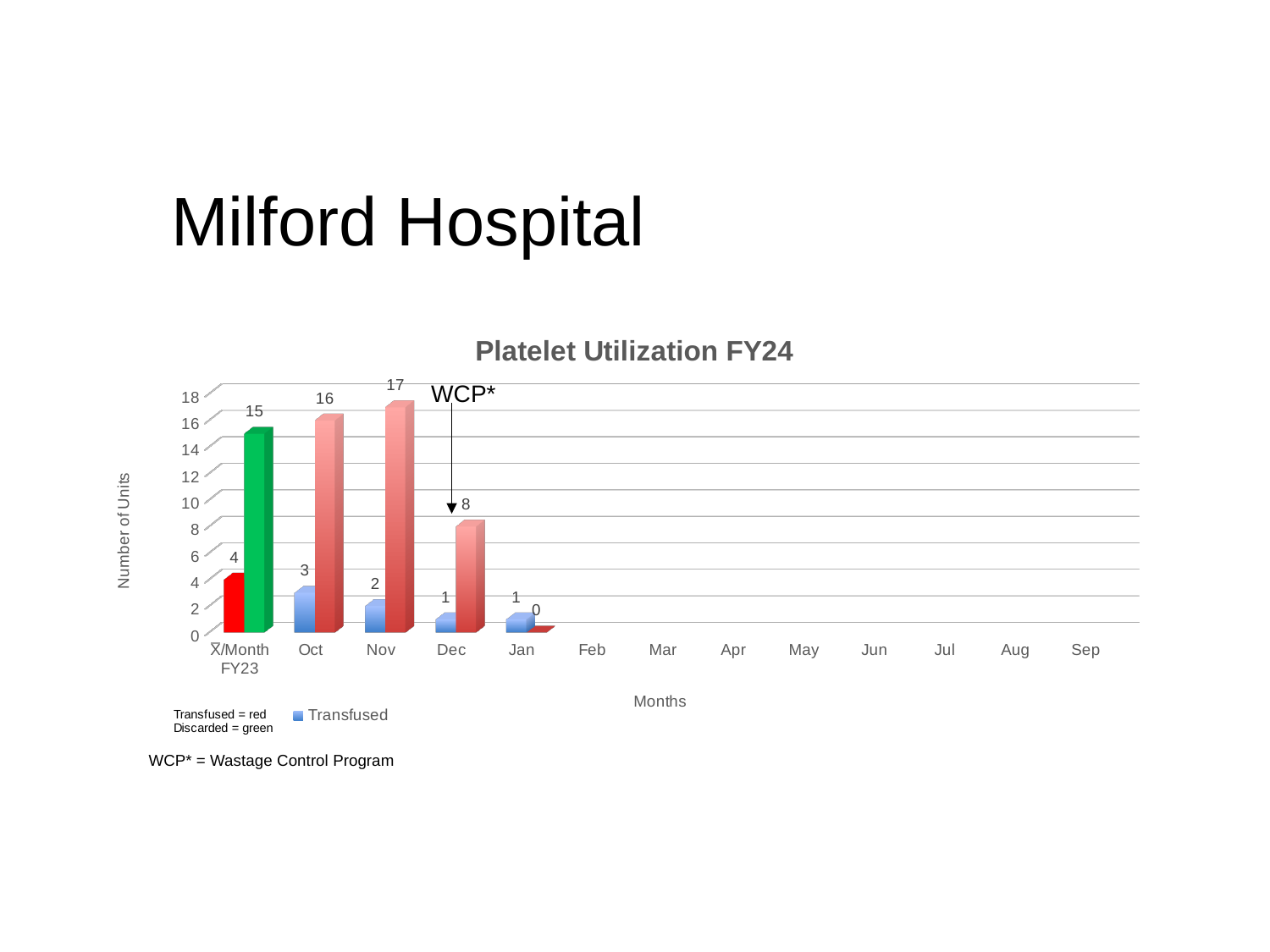
What is the difference between the pink bar for Oct (16) and the pink bar for Dec (8)? 8 What is the title of the chart? Platelet Utilization FY24 What type of chart is shown on the slide? bar chart Do the Transfused values rise or fall from Oct to Jan? fall What is the value of the taller (pink) bar for Nov? 17 What is the value of the taller (pink) bar for Dec? 8 How many categories are shown on the x axis? 13 What is the Transfused value for X̄/Month FY23? 4 What is the Discarded (green bar) value for X̄/Month FY23? 15 Which month from Oct to Jan has the highest pink (non-transfused) bar? Nov How many series does the legend list? 1 What is the Transfused value for Oct? 3